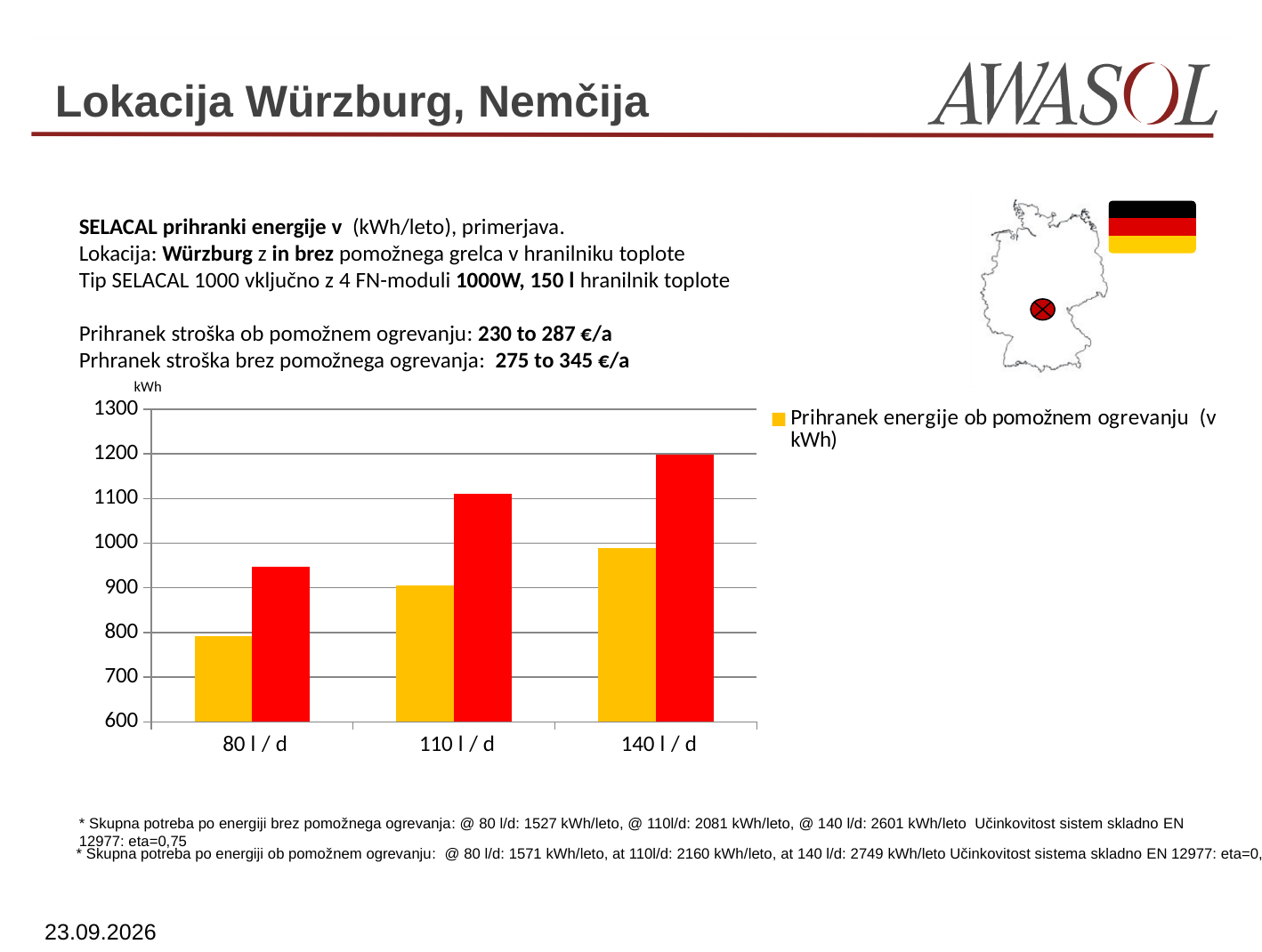
Which category has the tallest bar in the chart? 140 l / d For 80 l / d, which bar is larger, the yellow bar or the red bar? the red bar What unit label is printed at the top of the chart's vertical axis? kWh Is the value of the yellow bar for 110 l / d greater or less than 1000? less Is the value of the red bar for 80 l / d greater or less than 900? greater Is the value of the yellow bar for 80 l / d greater or less than 700? greater What kind of chart is shown on the slide? bar chart Do the yellow bars rise or fall from 80 l / d to 140 l / d? rise How many categories are shown on the x axis of the chart? 3 What is the legend entry shown next to the chart? Prihranek energije ob pomožnem ogrevanju (v kWh) How many series does the chart's legend list? 1